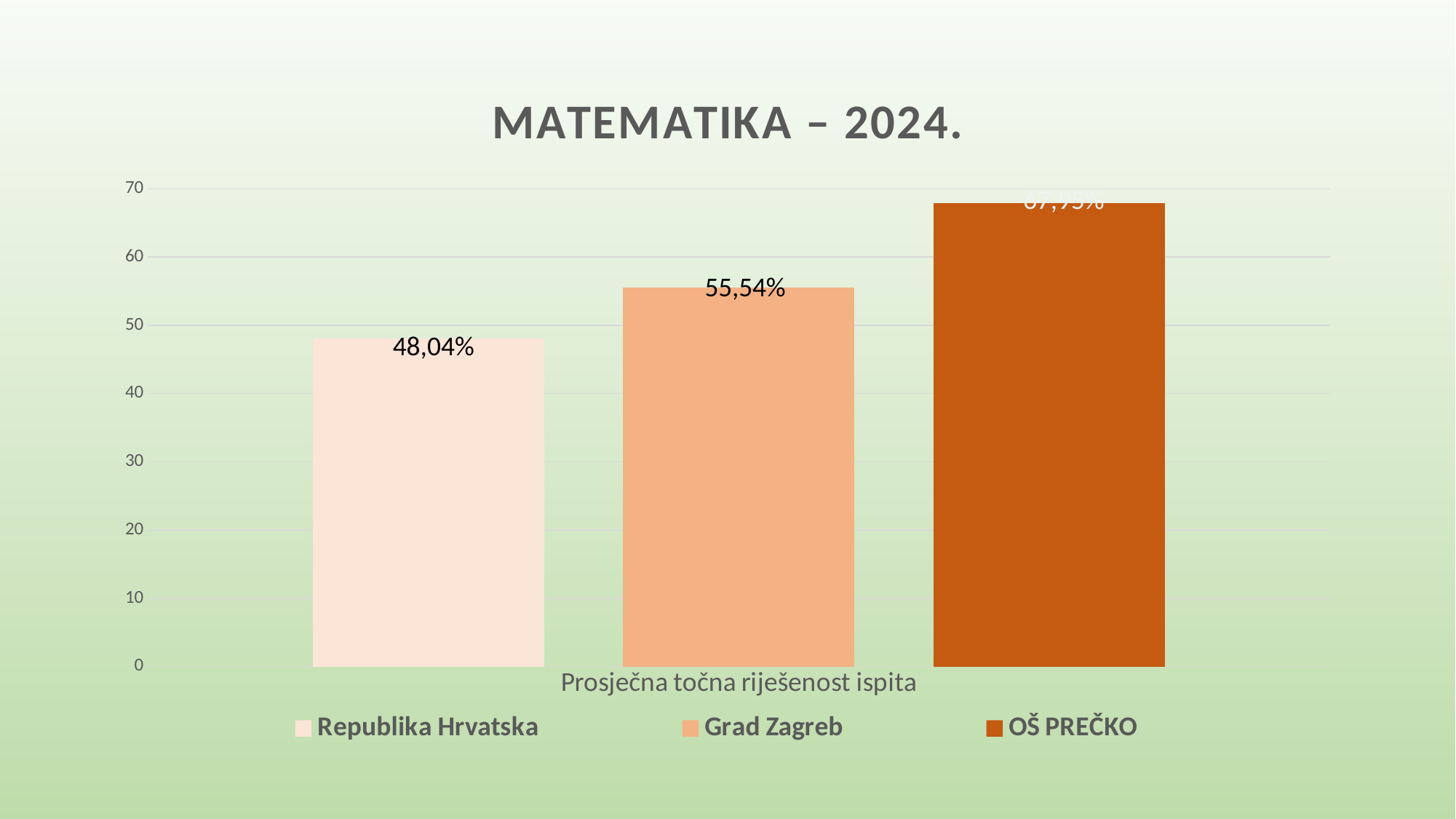
What is the value for Republika Hrvatska? 48,04% How many series does the legend list? 3 How many bars are plotted on the chart? 3 What kind of chart is shown on the slide? bar chart Which series has the lowest value? Republika Hrvatska Is the value for Republika Hrvatska greater or less than 50? less Is the value for OŠ PREČKO greater or less than 60? greater What is the value for Grad Zagreb? 55,54% What is the difference between the values for Grad Zagreb and Republika Hrvatska? 7,50% Which series has the highest value? OŠ PREČKO What is the title of the chart? MATEMATIKA – 2024. Which is larger, the value for Grad Zagreb or the value for Republika Hrvatska? Grad Zagreb